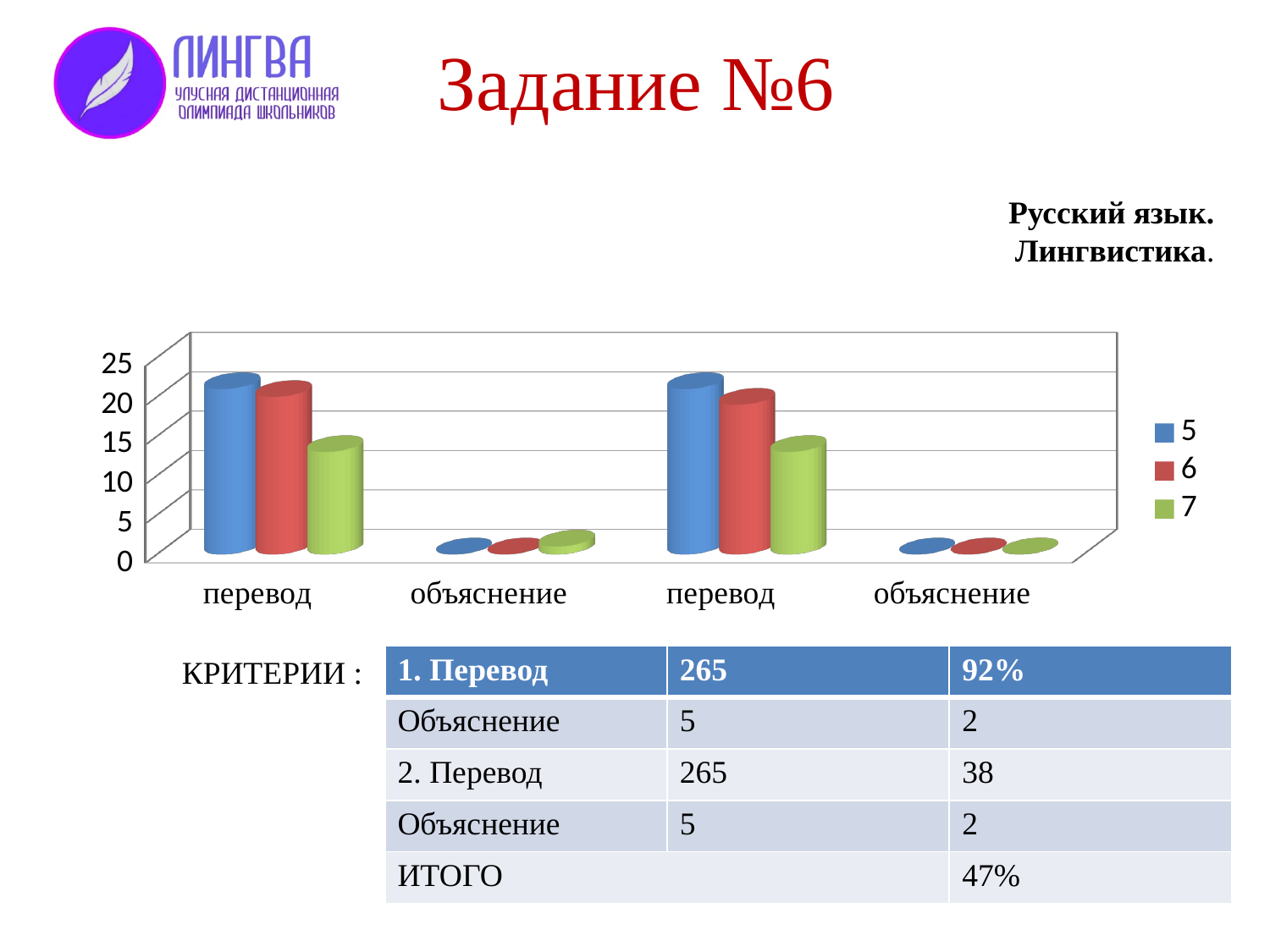
Which colour represents series 6 in the chart? red Is the value of series 5 for the first 'перевод' category greater or less than 15? greater For the second 'перевод' category, which series has the lowest value? 7 What are the entries in the chart legend? 5, 6, 7 What kind of chart is shown on the slide? bar chart Is the value of series 5 for the first 'объяснение' category greater or less than 5? less Is the value of series 7 for the first 'перевод' category greater or less than 15? less Which category has the lowest values across all series: 'перевод' or 'объяснение'? объяснение How many series does the chart legend list? 3 For the first 'перевод' category, which is larger: series 5 or series 7? series 5 How many categories are shown along the x axis of the chart? 4